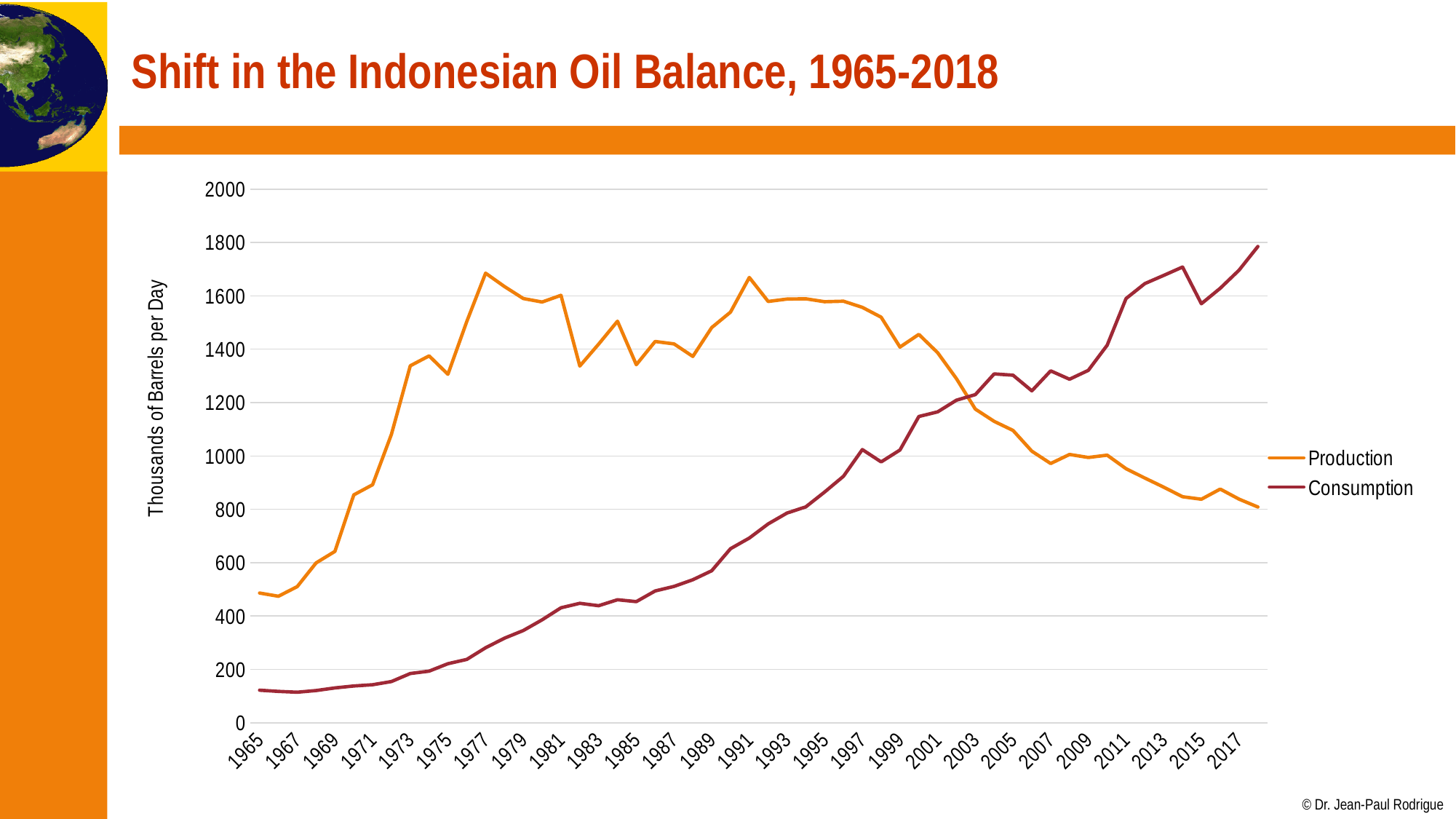
Is the Consumption value in 2017 greater or less than 1600? greater In 1965, which is larger, Production or Consumption? Production Is the Production value in 1977 greater or less than 1600? greater Is the Production value in 1965 greater or less than 600? less What is the label of the vertical axis? Thousands of Barrels per Day What kind of chart is shown on the slide? line chart How many series does the legend list? 2 Does the Consumption line generally rise or fall from 1965 to 2018? rise What are the two series named in the legend? Production and Consumption In 2017, which is larger, Production or Consumption? Consumption